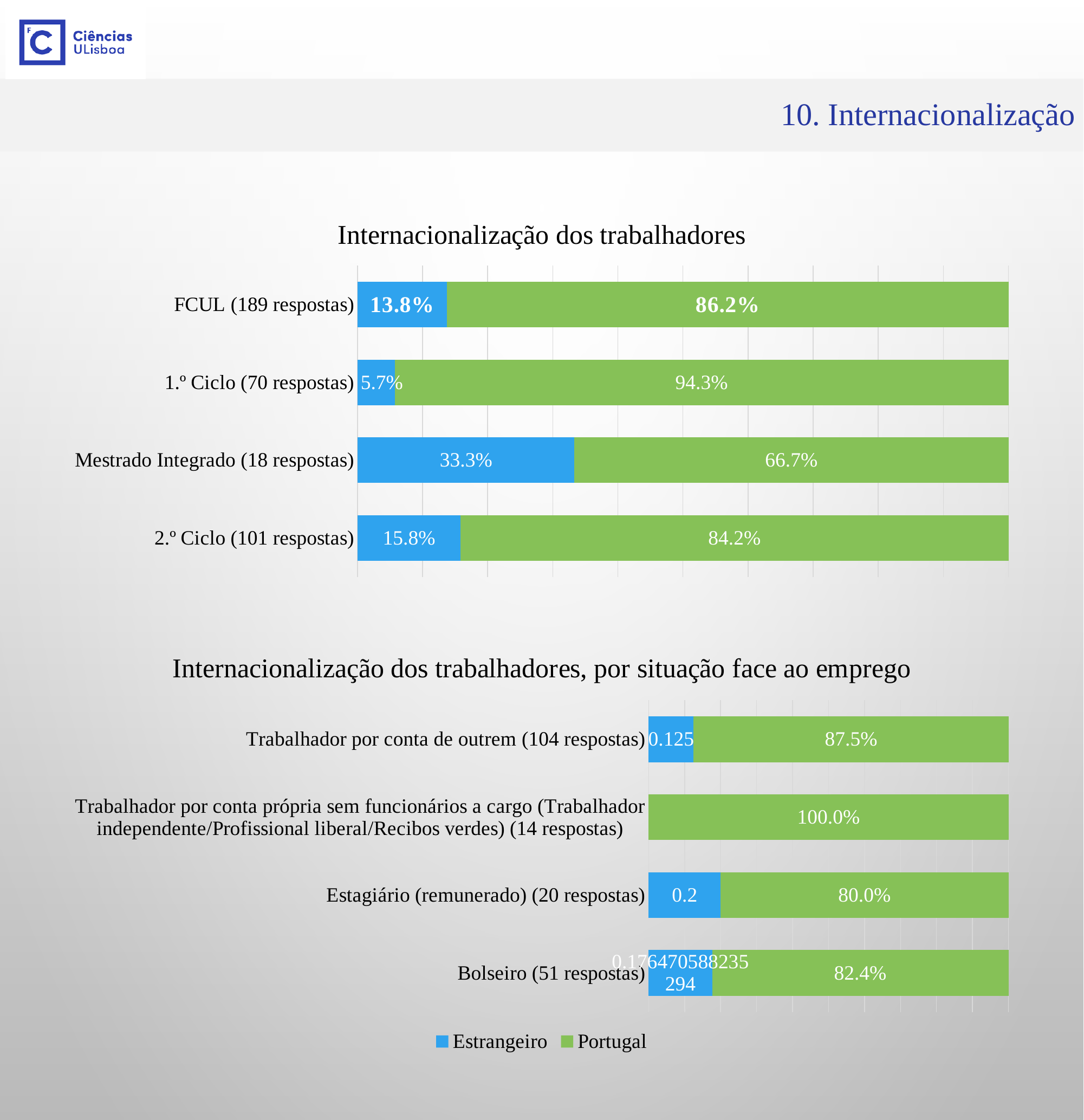
In the chart 'Internacionalização dos trabalhadores, por situação face ao emprego', what is the Portugal value for Estagiário (remunerado) (20 respostas)? 80.0% In the chart 'Internacionalização dos trabalhadores, por situação face ao emprego', is the Portugal value for Trabalhador por conta de outrem (104 respostas) larger or smaller than that for Estagiário (remunerado) (20 respostas)? larger In the chart 'Internacionalização dos trabalhadores', what is the Portugal value for 1.º Ciclo (70 respostas)? 94.3% In the chart 'Internacionalização dos trabalhadores, por situação face ao emprego', which category has the highest Portugal share? Trabalhador por conta própria sem funcionários a cargo (Trabalhador independente/Profissional liberal/Recibos verdes) (14 respostas) In the chart 'Internacionalização dos trabalhadores', which category has the highest Estrangeiro share? Mestrado Integrado (18 respostas) In the chart 'Internacionalização dos trabalhadores', what is the Estrangeiro value for FCUL (189 respostas)? 13.8% How many series does the legend list? 2 In the chart 'Internacionalização dos trabalhadores', what is the difference between the Portugal values for 2.º Ciclo (101 respostas) and Mestrado Integrado (18 respostas)? 17.5% In the chart 'Internacionalização dos trabalhadores', which category has the lowest Estrangeiro share? 1.º Ciclo (70 respostas) In the chart 'Internacionalização dos trabalhadores, por situação face ao emprego', what is the Portugal value for Bolseiro (51 respostas)? 82.4% In the chart 'Internacionalização dos trabalhadores', what is the Estrangeiro value for Mestrado Integrado (18 respostas)? 33.3% In the chart 'Internacionalização dos trabalhadores', how many categories are shown? 4